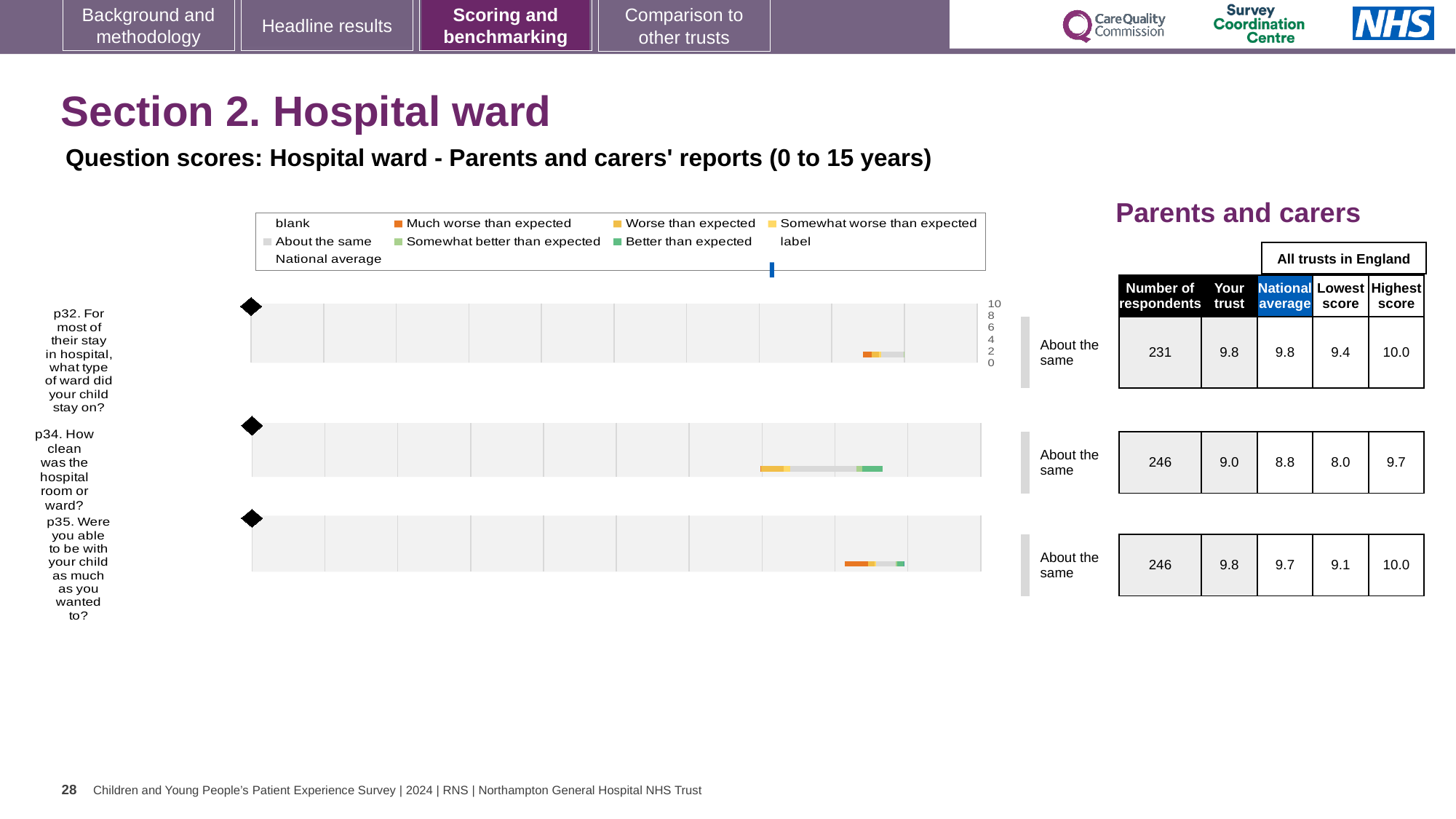
Which question has the lowest 'Your trust' score? p34. How clean was the hospital room or ward? How many questions (rows) are plotted in the chart on this slide? 3 What is the 'Your trust' score for p34 (How clean was the hospital room or ward?)? 9.0 What kind of chart is used to show the question scores on this slide? bar chart What is the difference between the 'Your trust' score and the national average for p35? 0.1 What is the difference between the highest score and the lowest score for p34? 1.7 What colour represents 'Better than expected' in the legend? green How many respondents answered p32 (For most of their stay in hospital, what type of ward did your child stay on?)? 231 What benchmark category label is shown for p32? About the same For p34, which is larger: the 'Your trust' score or the national average? Your trust What is the national average score for p35 (Were you able to be with your child as much as you wanted to?)? 9.7 What is the lowest score among all trusts in England for p34? 8.0